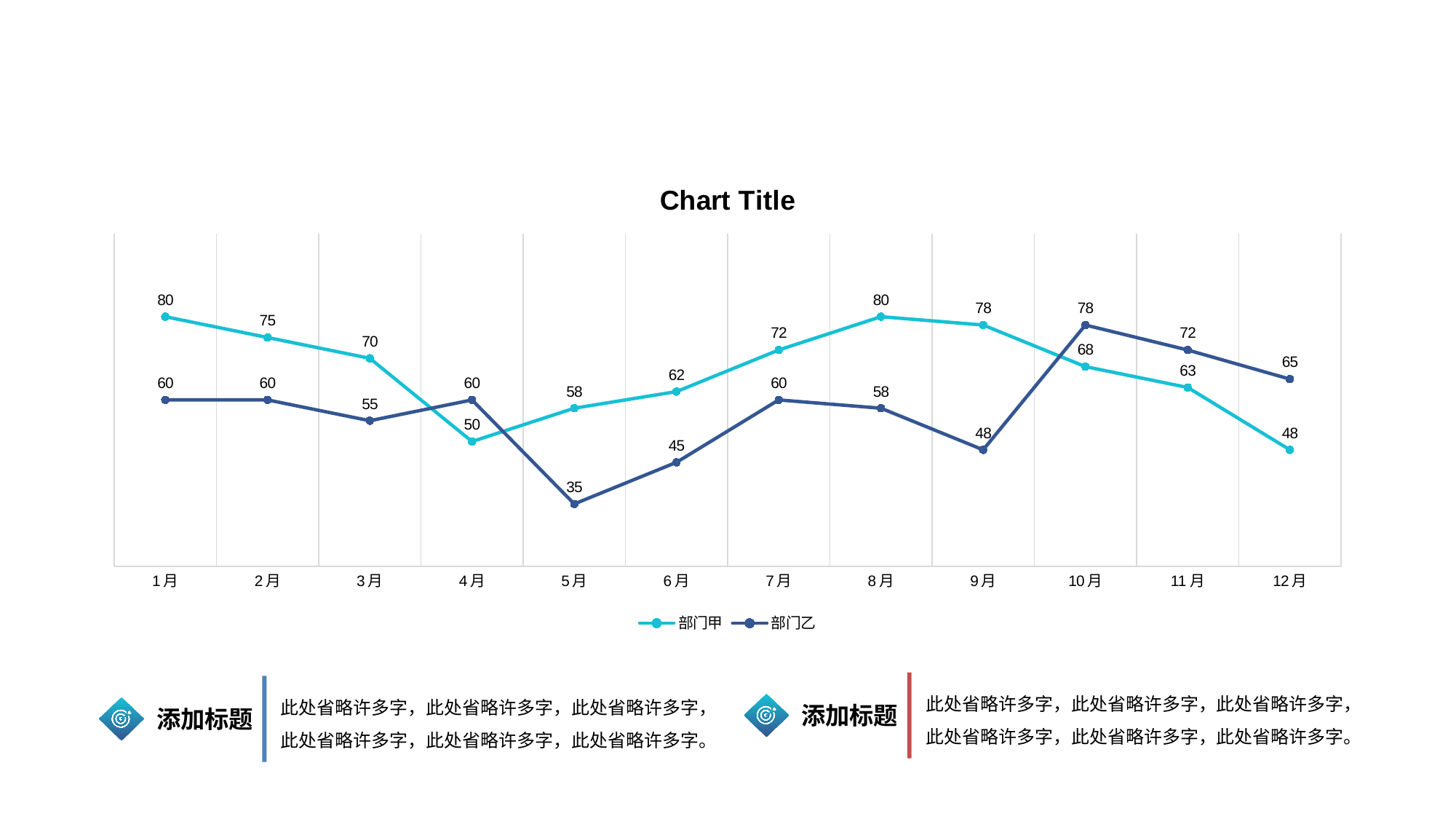
What is the value for 部门乙 in 10月? 78 In which month does 部门乙 reach its lowest value? 5月 What is the difference between 部门乙 in 10月 and 部门乙 in 9月? 30 In which month does 部门甲 have its lowest value? 12月 What is the difference between 部门甲 and 部门乙 in 1月? 20 Which series has the larger value in 11月, 部门甲 or 部门乙? 部门乙 What kind of chart is shown on the slide? Line chart In which month does 部门乙 reach its highest value? 10月 What is the value for 部门甲 in 4月? 50 What is the value for 部门乙 in 5月? 35 How many series does the legend list? 2 How many months are shown on the x axis? 12